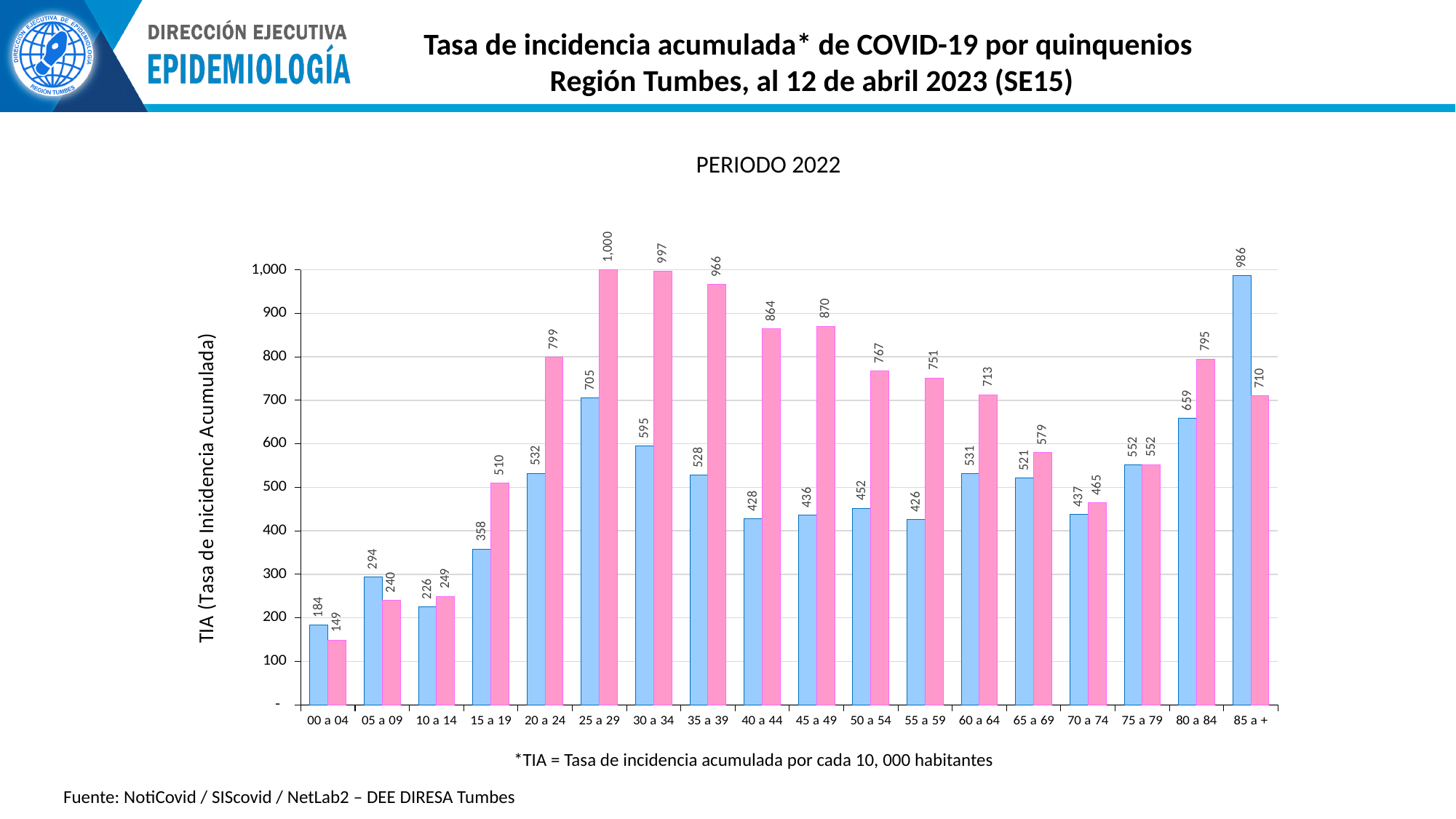
What is the label of the vertical axis? TIA (Tasa de Incidencia Acumulada) What is the title shown above the chart? PERIODO 2022 How many age groups are shown on the x axis? 18 What is the value of the pink bar for the 40 a 44 age group? 864 What is the value of the blue bar for the 25 a 29 age group? 705 What is the value of the blue bar for the 85 a + age group? 986 Which age group has the highest pink bar? 25 a 29 What kind of chart is shown on the slide? bar chart Which is larger for the 85 a + age group, the blue bar or the pink bar? the blue bar What is the difference between the pink and blue bars for the 20 a 24 age group? 267 Which age group has the lowest blue bar? 00 a 04 Is the value of the pink bar for the 30 a 34 age group greater or less than 900? greater